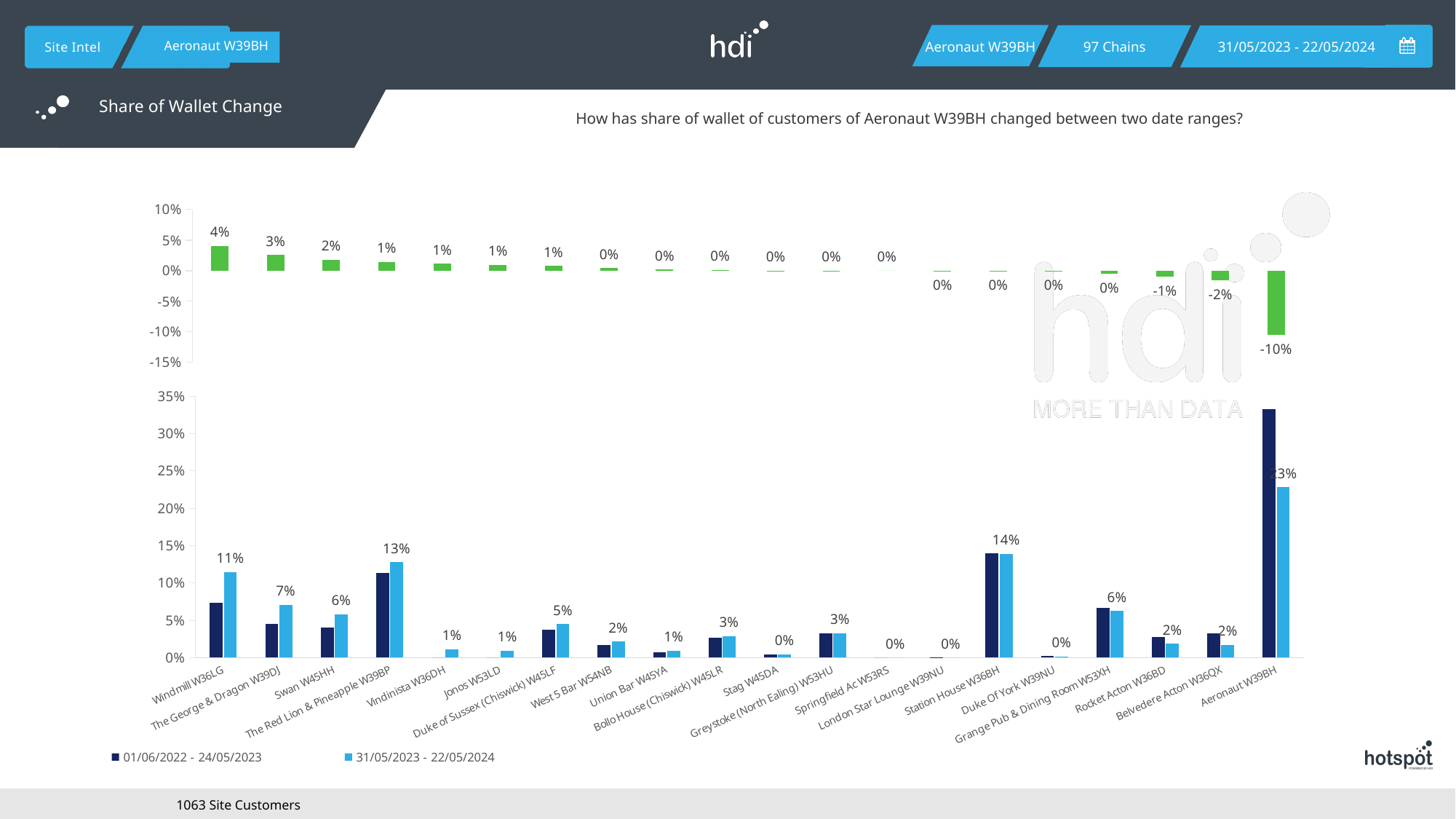
In the top chart (share of wallet change), do the values rise or fall from left to right along the x axis? fall In the top chart (share of wallet change), which venue has the lowest value? Aeronaut W39BH In the bottom chart, is the value for Aeronaut W39BH in the 01/06/2022 - 24/05/2023 series greater or less than 30%? greater In the bottom chart, which is larger in the 31/05/2023 - 22/05/2024 series: The Red Lion & Pineapple W39BP or Windmill W36LG? The Red Lion & Pineapple W39BP In the bottom chart, what is the labelled value for Station House W36BH in the 31/05/2023 - 22/05/2024 series? 14% How many series does the legend of the bottom chart list? 2 In the top chart (share of wallet change), what is the value for Aeronaut W39BH? -10% In the top chart (share of wallet change), which venue has the highest value? Windmill W36LG In the top chart (share of wallet change), what is the difference between the values for Windmill W36LG and The George & Dragon W39DJ? 1% How many venues are shown on the x axis of the bottom chart? 20 In the top chart (share of wallet change), what is the value for Windmill W36LG? 4% In the bottom chart, which venue has the highest value in the 31/05/2023 - 22/05/2024 series? Aeronaut W39BH